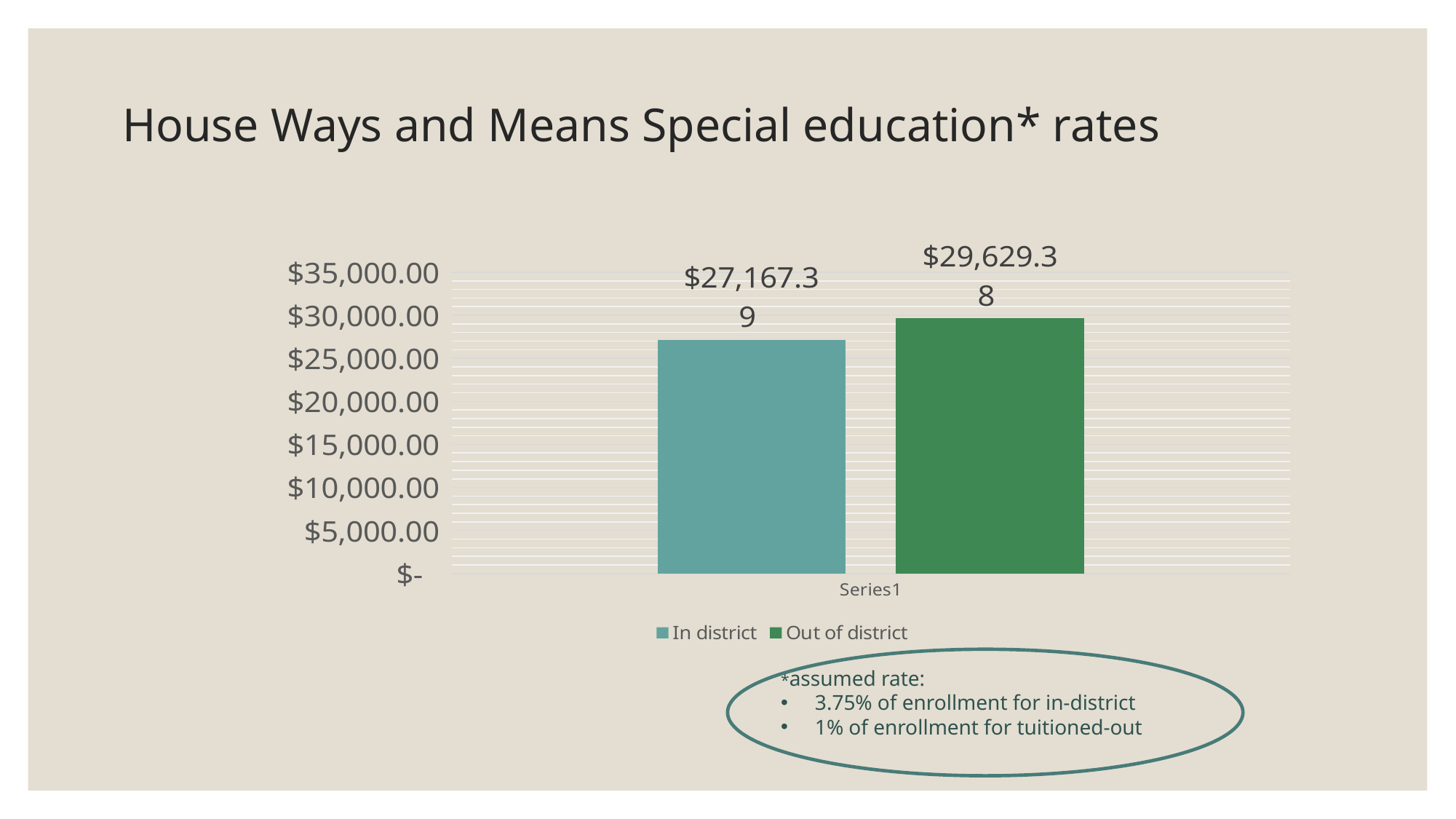
How many series does the legend list? 2 What is the value for In district? $27,167.39 What is the category label shown on the x axis? Series1 What is the highest value shown on the y axis? $35,000.00 What is the title of the slide? House Ways and Means Special education* rates What kind of chart is shown on the slide? Bar chart What is the value for Out of district? $29,629.38 Is the value for In district greater or less than $25,000.00? greater What is the difference between the Out of district and In district values? $2,461.99 Is the value for Out of district greater or less than $30,000.00? less Which series has the higher value, In district or Out of district? Out of district Which series has the lower value? In district